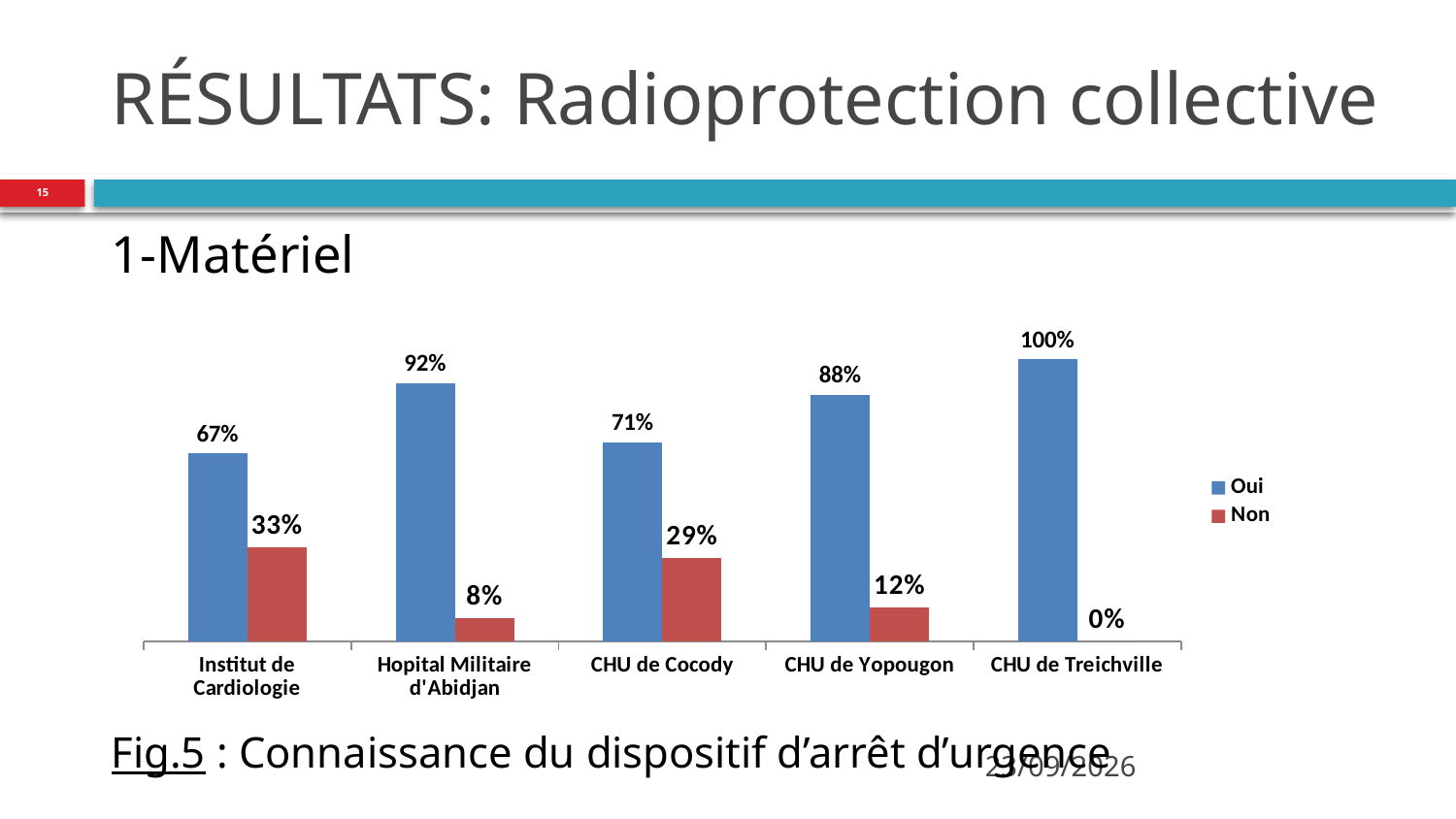
Which category has the highest 'Oui' value? CHU de Treichville How many series does the legend list? 2 How many categories are shown on the x axis? 5 What kind of chart is shown on the slide? Bar chart Which colour represents the 'Non' series in the legend? Red What is the 'Oui' value for CHU de Cocody? 71% Which category has the lowest 'Non' value? CHU de Treichville What is the 'Non' value for Hopital Militaire d'Abidjan? 8% Which category has the lowest 'Oui' value? Institut de Cardiologie Which is larger, the 'Oui' value for Hopital Militaire d'Abidjan or the 'Oui' value for CHU de Yopougon? Hopital Militaire d'Abidjan What is the difference between the 'Oui' and 'Non' values for CHU de Yopougon? 76% What is the 'Non' value for Institut de Cardiologie? 33%